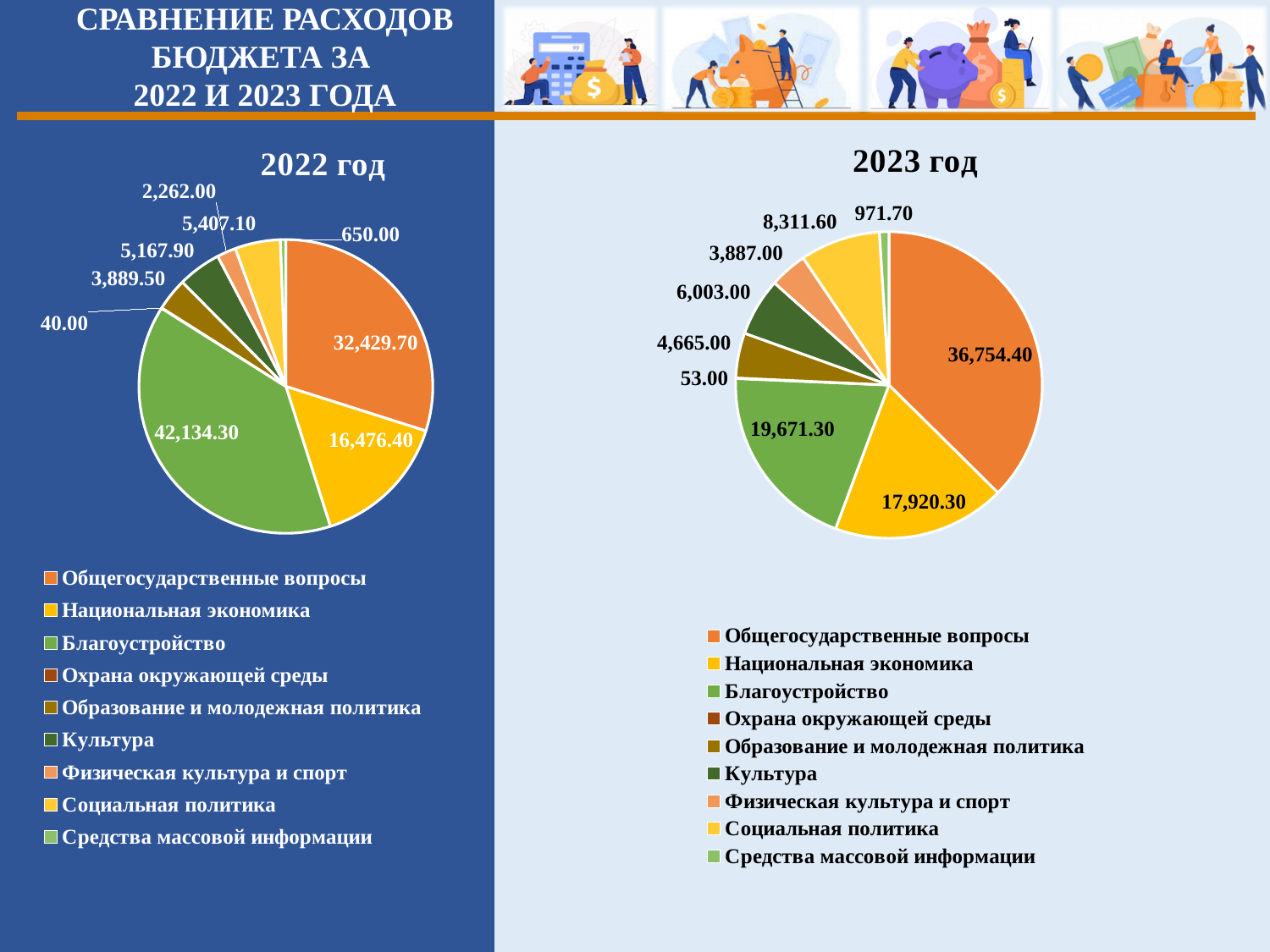
In the "2023 год" chart, what is the value for Национальная экономика? 17,920.30 In the "2022 год" chart, what is the value for Благоустройство? 42,134.30 In the "2023 год" chart, what is the difference between Благоустройство and Национальная экономика? 1,751.00 In the "2023 год" chart, what is the value for Социальная политика? 8,311.60 In the "2023 год" chart, what is the value for Культура? 6,003.00 In the "2023 год" chart, which category has the largest slice? Общегосударственные вопросы In the "2023 год" chart, what is the value for Общегосударственные вопросы? 36,754.40 In the "2023 год" chart, which category has the smallest slice? Охрана окружающей среды In the "2022 год" chart, which category has the largest slice? Благоустройство What type of chart is the "2022 год" chart? pie chart In the "2022 год" chart, which is larger: Общегосударственные вопросы or Национальная экономика? Общегосударственные вопросы How many categories does the legend of the "2023 год" chart list? 9